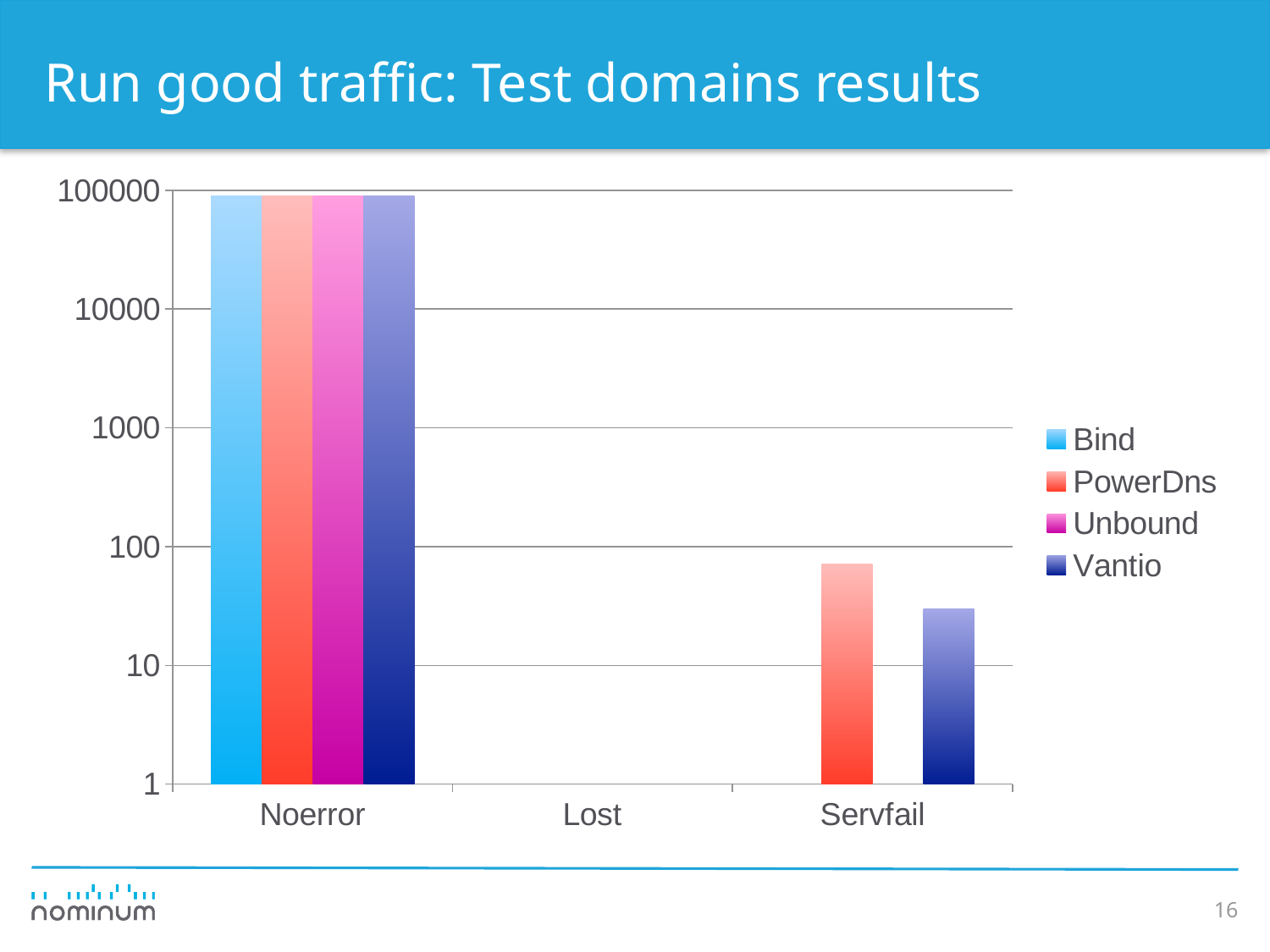
How many series does the legend list? 4 Is the value for Vantio in the Servfail category greater or less than 100? less Which series is shown in pink/magenta in the legend? Unbound Is the value for PowerDns in the Servfail category greater or less than 10? greater Is the value for PowerDns in the Servfail category greater or less than 100? less Which series has the highest value in the Servfail category? PowerDns What kind of chart is shown on the slide? bar chart What is the title of the slide containing the chart? Run good traffic: Test domains results In the Servfail category, which is larger: the PowerDns value or the Vantio value? PowerDns How many categories are shown on the x axis? 3